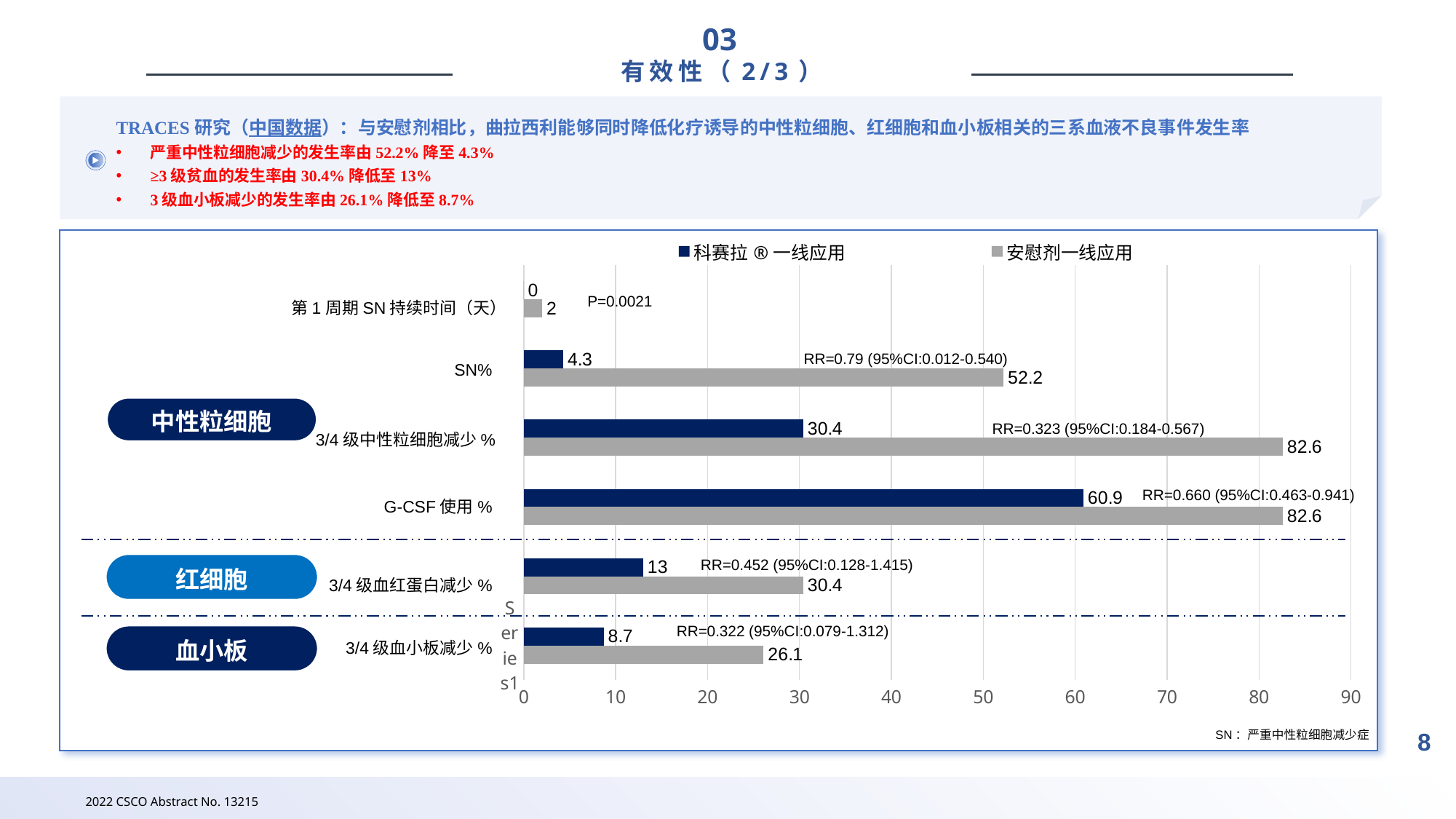
What is the value for 科赛拉® 一线应用 in the G-CSF 使用 % category? 60.9 What is the value for 科赛拉® 一线应用 in the 3/4 级血小板减少 % category? 8.7 How many categories are plotted on the chart? 6 Which colour represents the 安慰剂一线应用 series in the chart? gray What is the value for 安慰剂一线应用 in the SN% category? 52.2 In the 3/4 级血红蛋白减少 % category, which series has the larger value, 科赛拉® 一线应用 or 安慰剂一线应用? 安慰剂一线应用 How many series does the chart legend list? 2 What is the value for 安慰剂一线应用 in the 第 1 周期 SN 持续时间（天） category? 2 Which category has the highest value for 科赛拉® 一线应用? G-CSF 使用 % What type of chart is shown on the slide? bar chart Which category has the lowest value for 科赛拉® 一线应用? 第 1 周期 SN 持续时间（天） What is the difference between the 安慰剂一线应用 and 科赛拉® 一线应用 values in the 3/4 级中性粒细胞减少 % category? 52.2